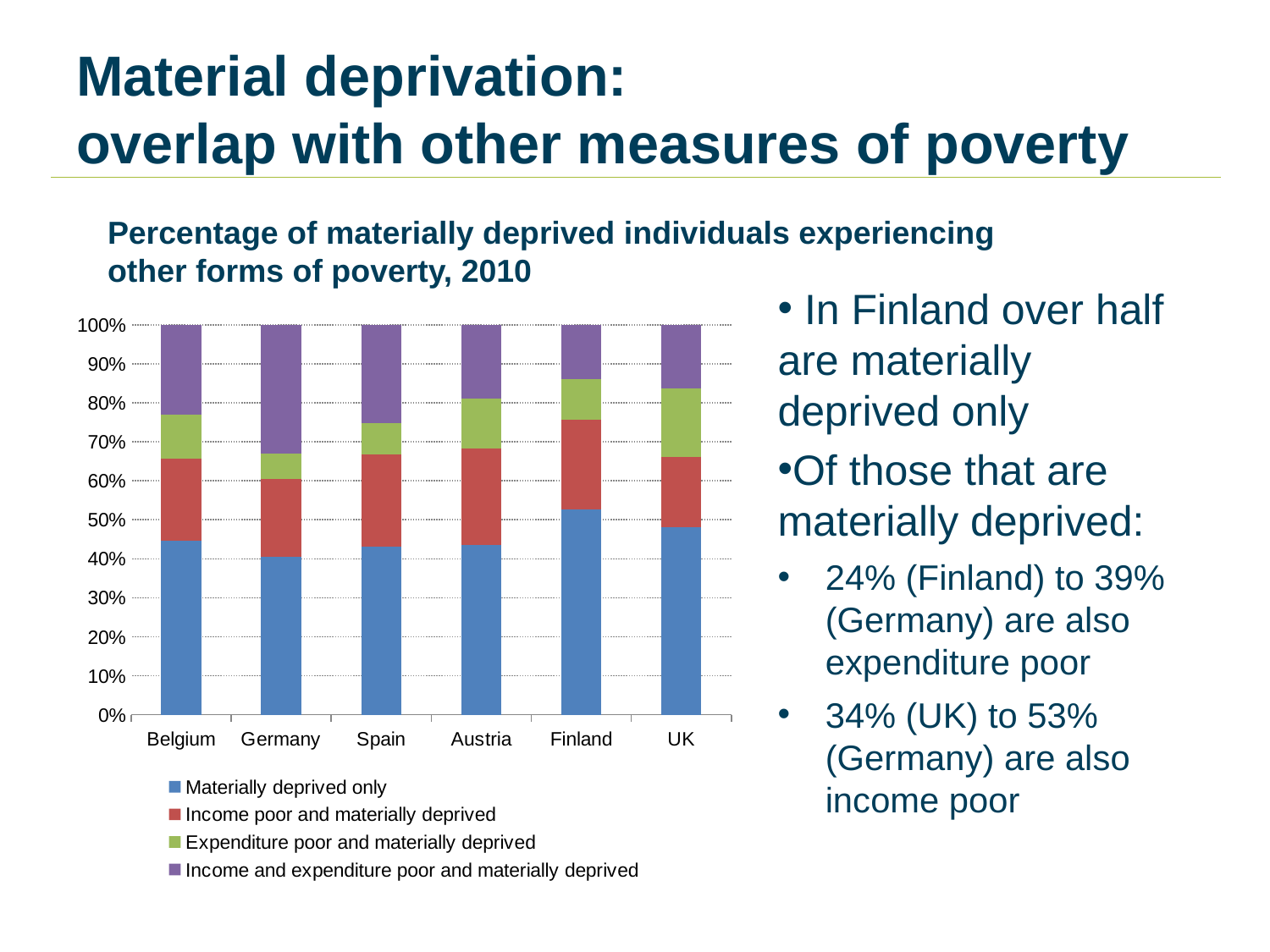
Is the 'Materially deprived only' value for Belgium greater or less than 50%? less What is the total height of each stacked bar in the chart? 100% What is the title of the chart? Percentage of materially deprived individuals experiencing other forms of poverty, 2010 How many countries are shown on the x axis of the chart? 6 How many series does the chart legend list? 4 Which is larger: the 'Materially deprived only' segment for Finland or for Germany? Finland Is the 'Materially deprived only' value for Finland greater or less than 50%? greater Which country has the largest 'Income and expenditure poor and materially deprived' segment? Germany Which is larger: the 'Income and expenditure poor and materially deprived' segment for Germany or for Finland? Germany Which country has the largest 'Materially deprived only' segment? Finland What type of chart is shown on the slide? Stacked bar chart Is the 'Materially deprived only' value for Germany greater or less than 50%? less